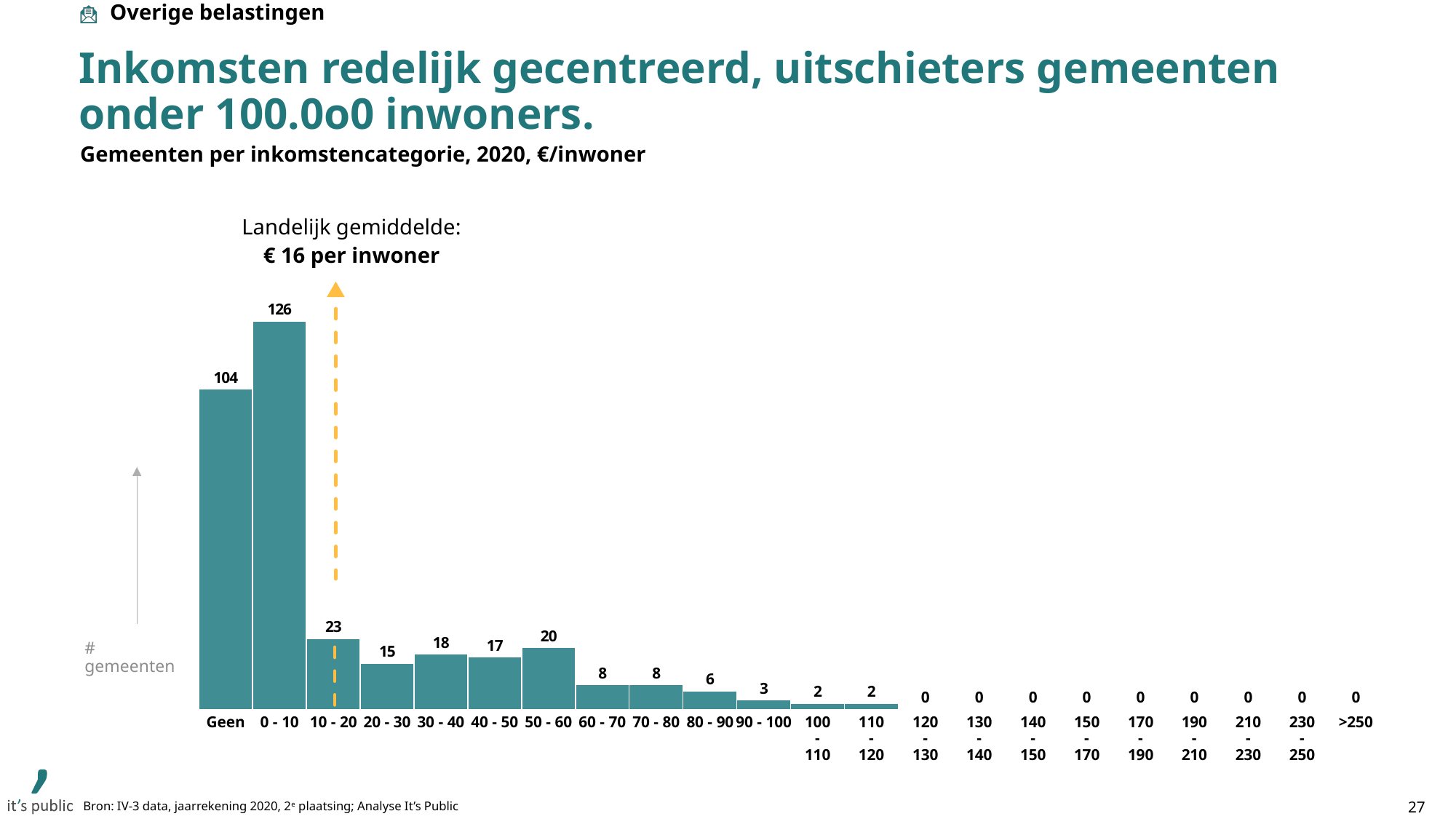
What is the difference between the '0 - 10' and 'Geen' categories? 22 What is the value for the '90 - 100' category? 3 What is the subtitle of the chart? Gemeenten per inkomstencategorie, 2020, €/inwoner What is the difference between the '10 - 20' and '20 - 30' categories? 8 How many gemeenten are in the 'Geen' category? 104 How many gemeenten are in the '0 - 10' category? 126 What kind of chart is shown on the slide? Bar chart How many categories are shown on the x axis? 22 Which category has the highest number of gemeenten? 0 - 10 What is the national average (Landelijk gemiddelde) indicated on the chart? € 16 per inwoner What is the value for the '50 - 60' category? 20 Which is larger, the value for '30 - 40' or the value for '40 - 50'? 30 - 40